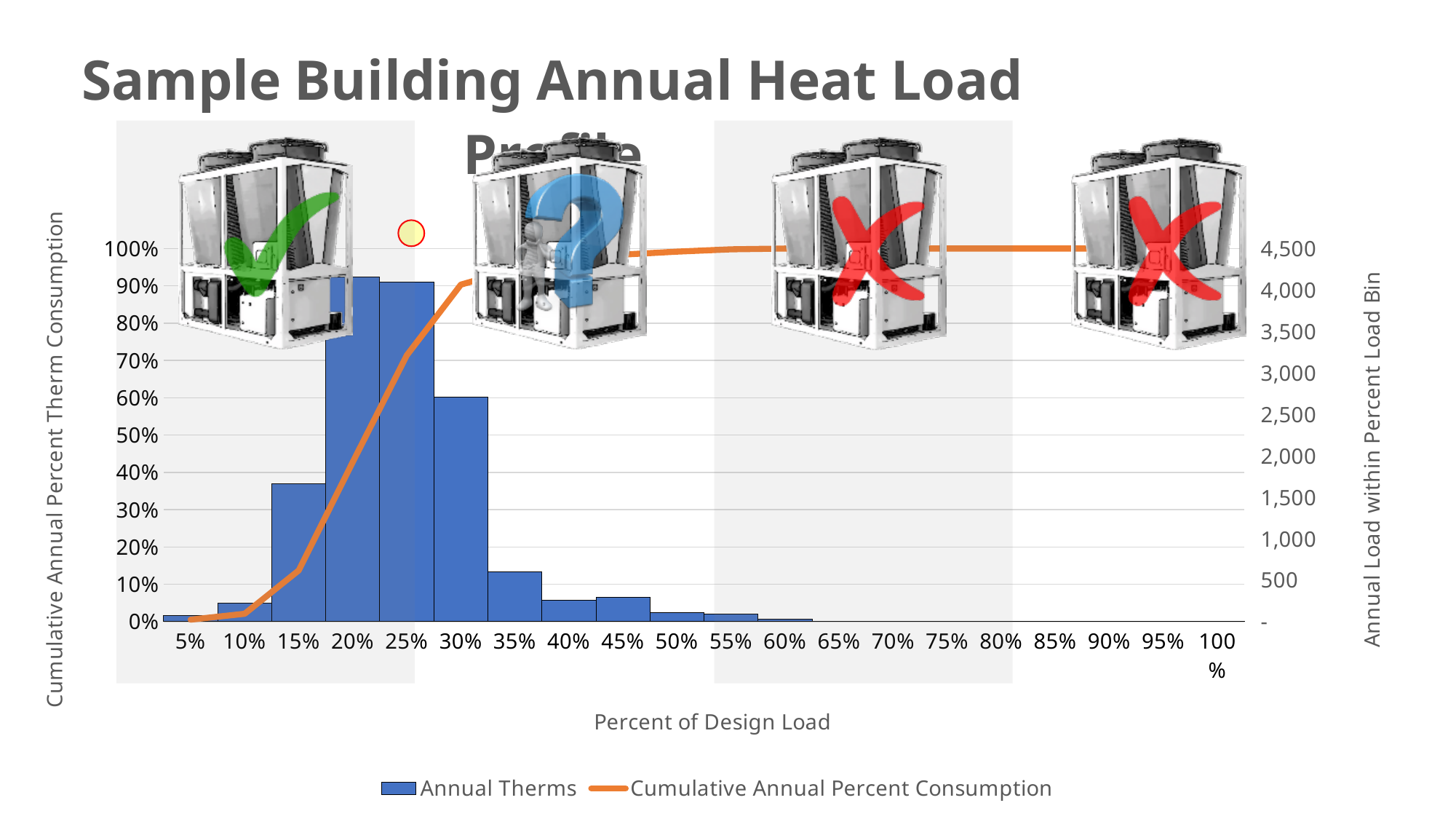
How many series does the legend list? 2 Is the Cumulative Annual Percent Consumption at the 20% bin greater or less than 50%? less Which bin has the larger Annual Therms value, 20% or 30%? 20% How many percent-of-design-load bins are shown on the x axis? 20 What is the title of the x axis? Percent of Design Load Which bin has the larger Annual Therms value, 15% or 35%? 15% What kind of chart is shown on the slide? Combination bar and line chart Is the Cumulative Annual Percent Consumption at the 35% bin greater or less than 90%? greater Is the Annual Therms value for the 40% bin greater or less than 500? less Which series is drawn as a line? Cumulative Annual Percent Consumption Does the Cumulative Annual Percent Consumption line rise or fall as the percent of design load increases? Rise